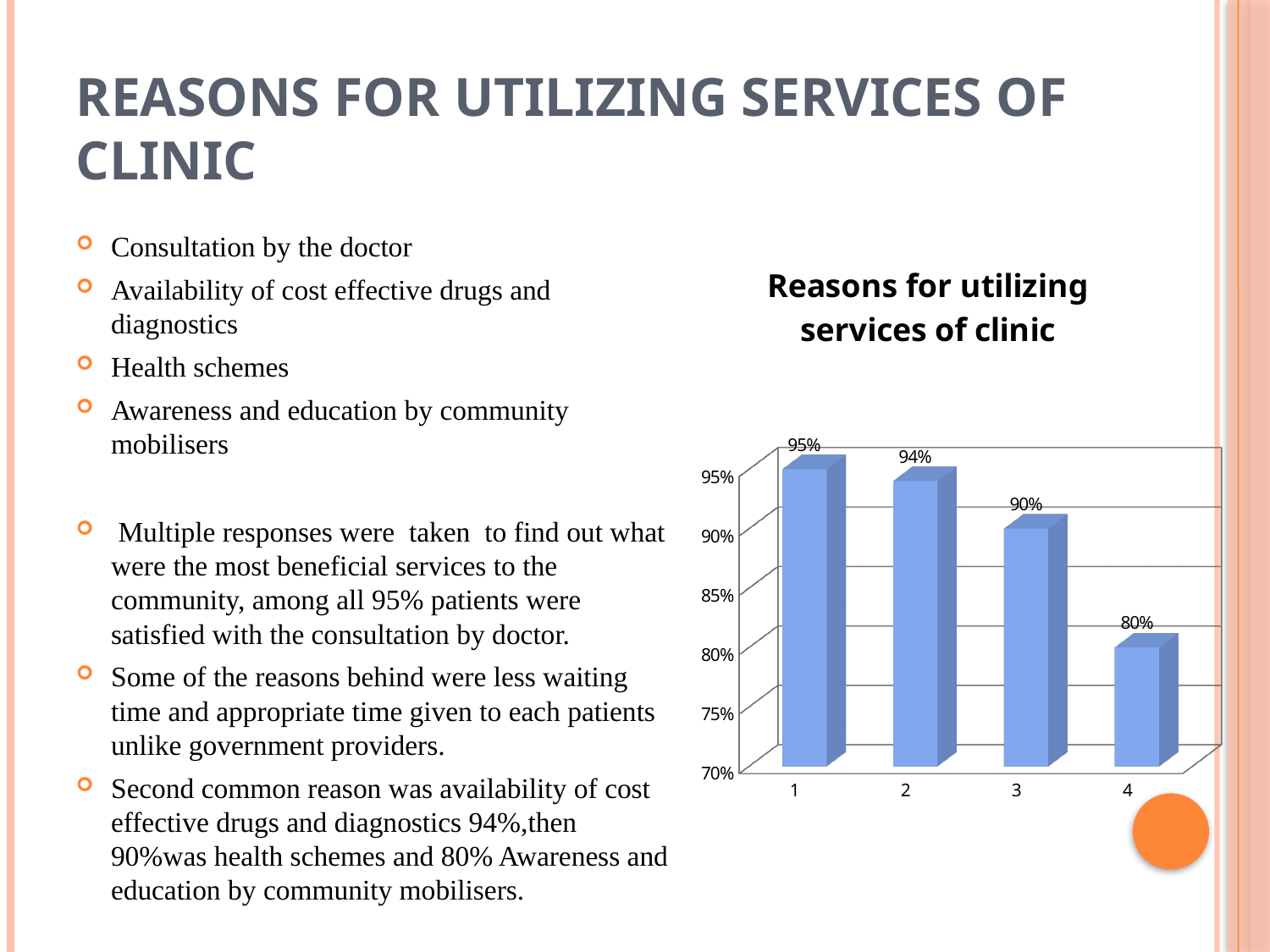
Which category has the highest value in the chart? 1 What is the value for category 1 in the chart? 95% How many categories are shown in the chart? 4 Which is larger, the value for category 3 or the value for category 4? 3 Do the values rise or fall from category 1 to category 4? fall Which category has the lowest value in the chart? 4 What is the value for category 2 in the chart? 94% What is the difference between the values for category 2 and category 3? 4% What is the difference between the values for category 1 and category 4? 15% What kind of chart is shown on the slide? bar chart What is the value for category 3 in the chart? 90% What is the value for category 4 in the chart? 80%